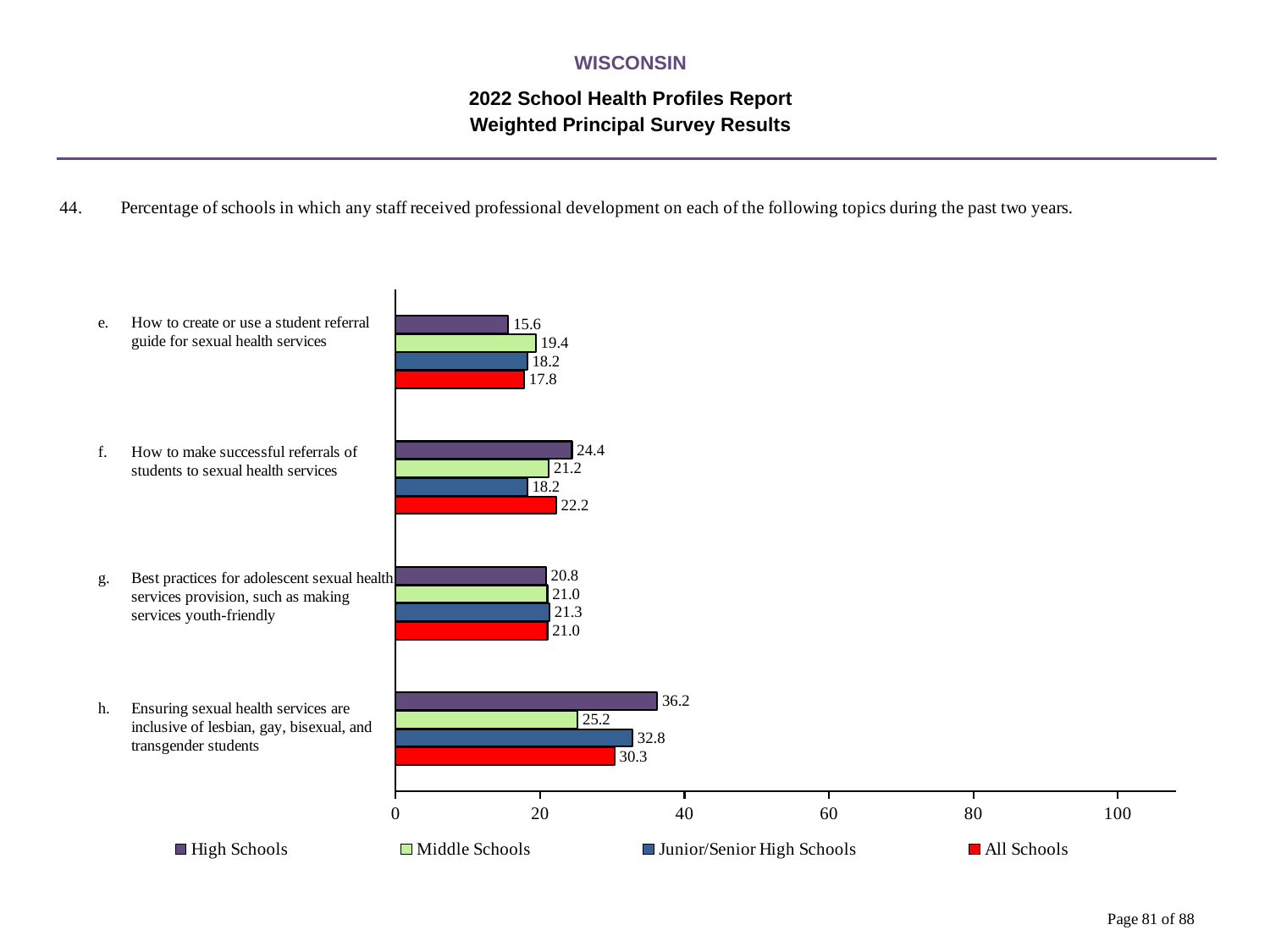
Which topic has the highest All Schools value? h. Ensuring sexual health services are inclusive of lesbian, gay, bisexual, and transgender students What is the difference between the High Schools and Middle Schools values for topic h? 11.0 Which topic has the lowest High Schools value? e. How to create or use a student referral guide for sexual health services What colour represents All Schools in the legend? Red How many series does the legend list? 4 What is the All Schools value for topic f, how to make successful referrals of students to sexual health services? 22.2 What kind of chart is shown on the slide? Bar chart What is the value for High Schools for topic h, ensuring sexual health services are inclusive of lesbian, gay, bisexual, and transgender students? 36.2 What is the Junior/Senior High Schools value for topic g, best practices for adolescent sexual health services provision? 21.3 What is the value for Middle Schools for topic e, how to create or use a student referral guide for sexual health services? 19.4 For topic f, which is larger: the High Schools value or the Junior/Senior High Schools value? High Schools How many topics (categories) are shown on the chart? 4